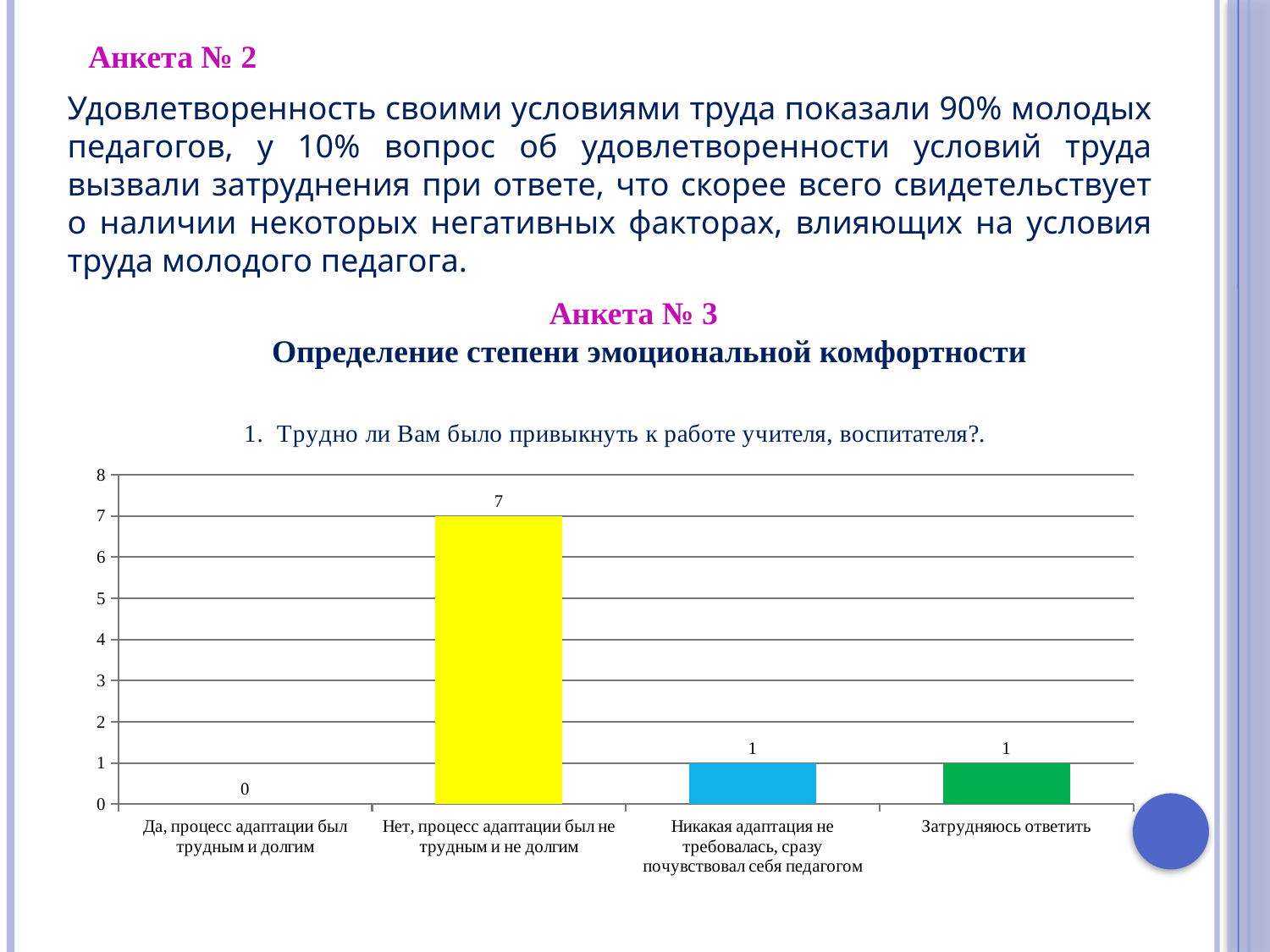
How many categories are shown on the x axis of the chart? 4 What is the title of the chart? 1. Трудно ли Вам было привыкнуть к работе учителя, воспитателя?. What kind of chart is shown on the slide? bar chart What is the difference between the values for "Нет, процесс адаптации был не трудным и не долгим" and "Затрудняюсь ответить"? 6 What value is shown for the category "Нет, процесс адаптации был не трудным и не долгим"? 7 What value is shown for the category "Затрудняюсь ответить"? 1 Is the value for "Нет, процесс адаптации был не трудным и не долгим" greater or less than 5? greater Which is larger: the value for "Нет, процесс адаптации был не трудным и не долгим" or the value for "Никакая адаптация не требовалась, сразу почувствовал себя педагогом"? Нет, процесс адаптации был не трудным и не долгим Which category has the highest value? Нет, процесс адаптации был не трудным и не долгим Which category has the lowest value? Да, процесс адаптации был трудным и долгим What value is shown for the category "Да, процесс адаптации был трудным и долгим"? 0 What value is shown for the category "Никакая адаптация не требовалась, сразу почувствовал себя педагогом"? 1